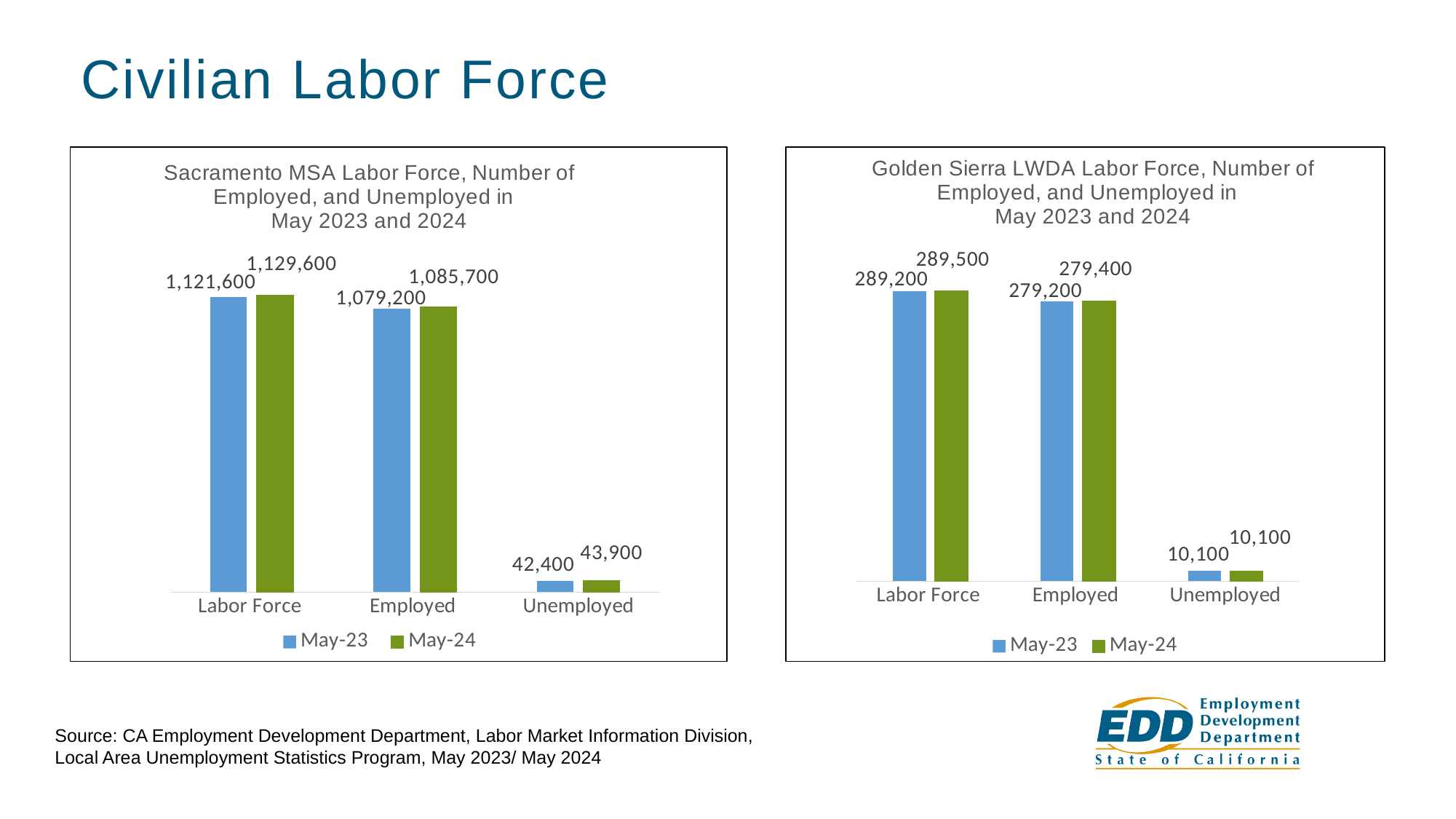
In the Sacramento MSA chart, is the Unemployed value larger for May-23 or May-24? May-24 In the Sacramento MSA chart, which category has the lowest values? Unemployed In the Sacramento MSA chart, what is the Unemployed value for May-23? 42,400 How many series does the legend list in the Golden Sierra LWDA chart? 2 In the Sacramento MSA chart, what is the Labor Force value for May-24? 1,129,600 In the Sacramento MSA chart, what is the difference between the Employed values for May-24 and May-23? 6,500 In the Golden Sierra LWDA chart, what is the difference between the Labor Force values for May-24 and May-23? 300 In the Golden Sierra LWDA chart, what is the Labor Force value for May-23? 289,200 What kind of chart is the Golden Sierra LWDA chart? Bar chart In the Golden Sierra LWDA chart, which category has the highest values? Labor Force In the Golden Sierra LWDA chart, what is the Employed value for May-24? 279,400 How many categories are shown on the x axis of the Sacramento MSA chart? 3